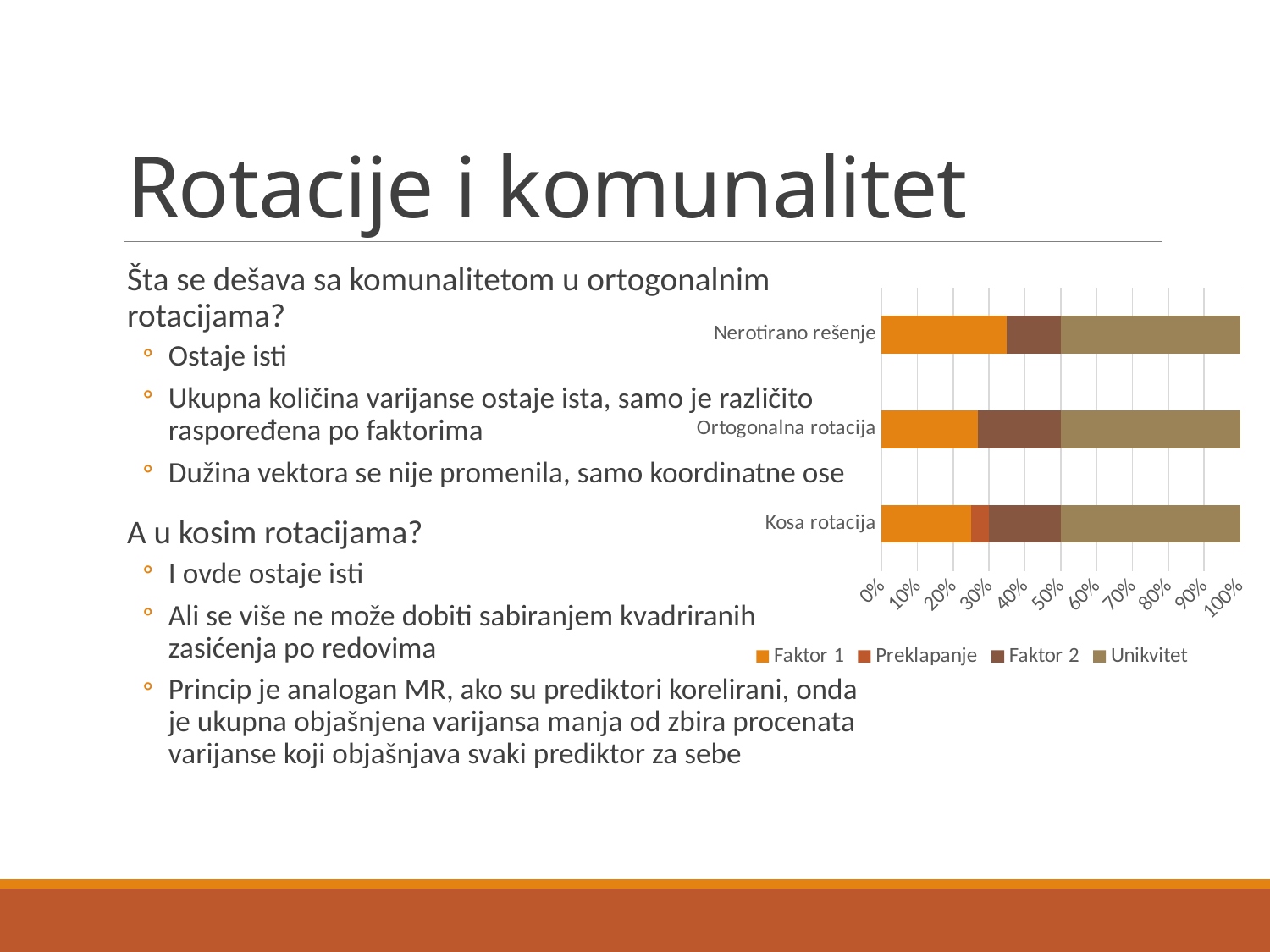
Is the Faktor 1 value for Kosa rotacija greater or less than 40%? less What kind of chart is shown on the slide? Stacked bar chart Which has a larger Faktor 2 segment, Nerotirano rešenje or Ortogonalna rotacija? Ortogonalna rotacija Which has a larger Faktor 1 segment, Nerotirano rešenje or Ortogonalna rotacija? Nerotirano rešenje How many series does the chart legend list? 4 Is the Faktor 1 value for Nerotirano rešenje greater or less than 30%? greater Is the Faktor 1 value for Ortogonalna rotacija greater or less than 20%? greater Which category has the largest Faktor 1 segment? Nerotirano rešenje Which series are listed in the chart legend? Faktor 1, Preklapanje, Faktor 2, Unikvitet How many categories are plotted on the chart's vertical axis? 3 What is the highest value shown on the chart's horizontal axis? 100% Which category is the only one with a visible Preklapanje segment? Kosa rotacija